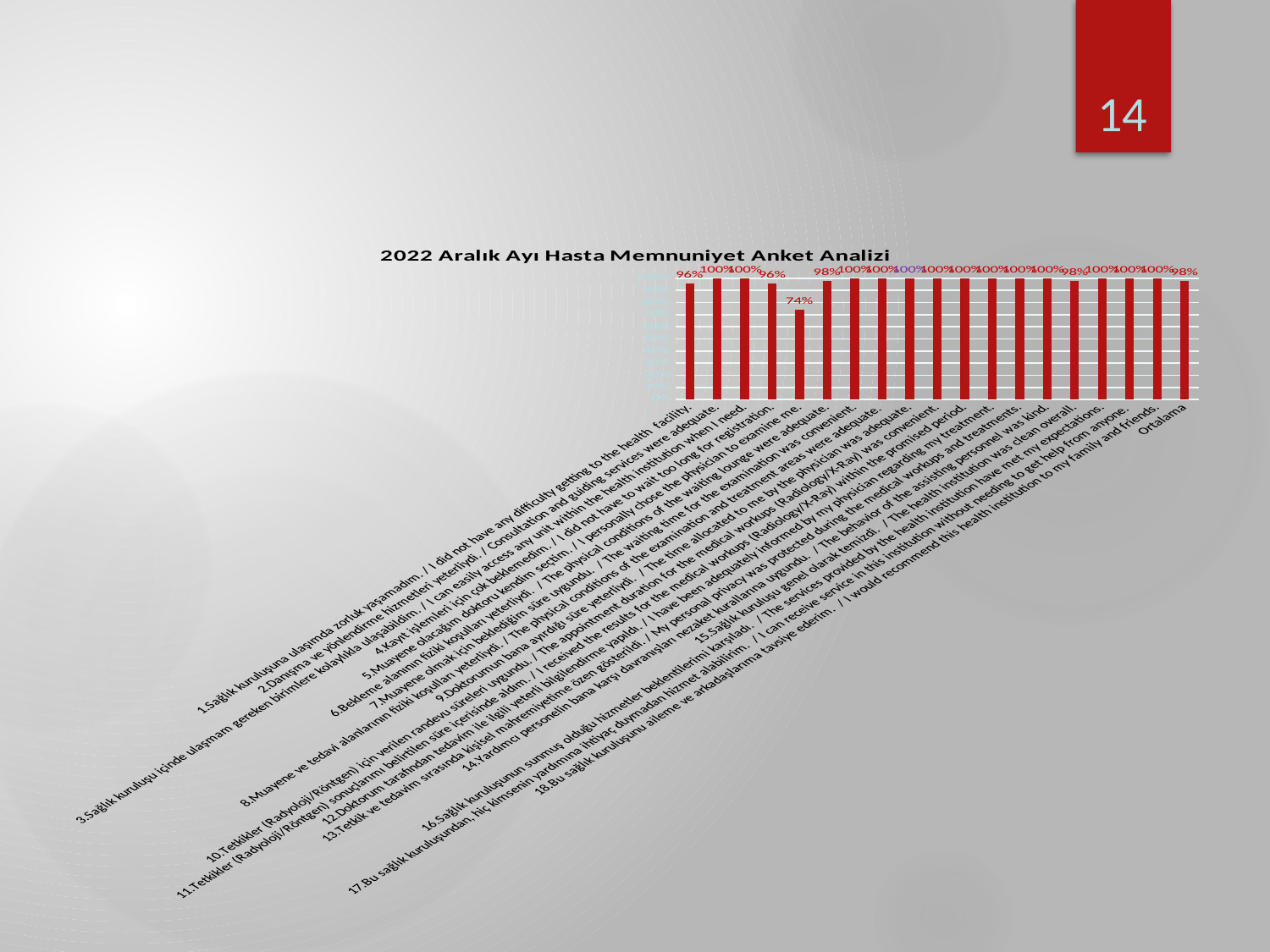
How many bars are plotted in the chart? 19 What is the value shown for the first bar in the chart? 96% Which category has the lowest value in the chart? 5.Muayene olacağım doktoru kendim seçtim. / I personally chose the physician to examine me. What is the title of the chart on the slide? 2022 Aralık Ayı Hasta Memnuniyet Anket Analizi What is the value for item 1, 'Sağlık kuruluşuna ulaşımda zorluk yaşamadım. / I did not have any difficulty getting to the health facility.'? 96% What is the difference between the 'Ortalama' value and the value for item 5? 24 percentage points What colour are the bars in the chart? Red What is the value shown for the 'Ortalama' bar? 98% Which is larger: the value for item 5 or the value for 'Ortalama'? Ortalama What is the difference between the value for item 1 (96%) and the value for item 5 (74%)? 22 percentage points What is the value for item 5, 'Muayene olacağım doktoru kendim seçtim. / I personally chose the physician to examine me.'? 74% What kind of chart is shown on the slide? Bar chart